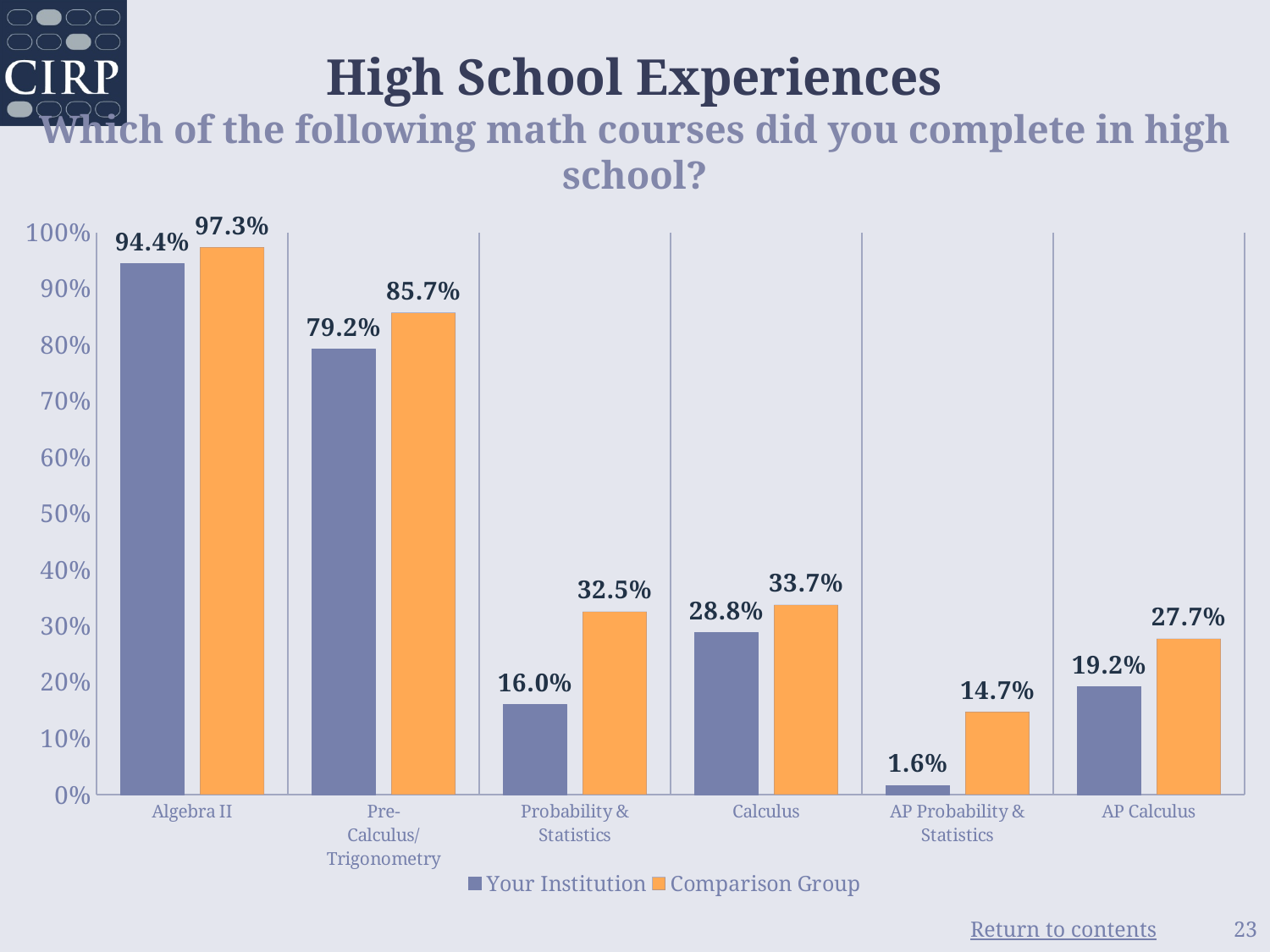
Which course has the highest value for the Comparison Group? Algebra II What is the difference between the Comparison Group and Your Institution values for Probability & Statistics? 16.5% Which is larger for AP Calculus: Your Institution or the Comparison Group? Comparison Group Which colour represents the Comparison Group in the chart? Orange What kind of chart is shown on the slide? Bar chart How many series does the legend list? 2 What is the value for the Comparison Group for Pre-Calculus/Trigonometry? 85.7% How many math courses are shown on the x axis? 6 What is the difference between the Comparison Group and Your Institution values for Calculus? 4.9% What is the value for Your Institution for Algebra II? 94.4% Which course has the lowest value for Your Institution? AP Probability & Statistics What is the value for Your Institution for AP Probability & Statistics? 1.6%